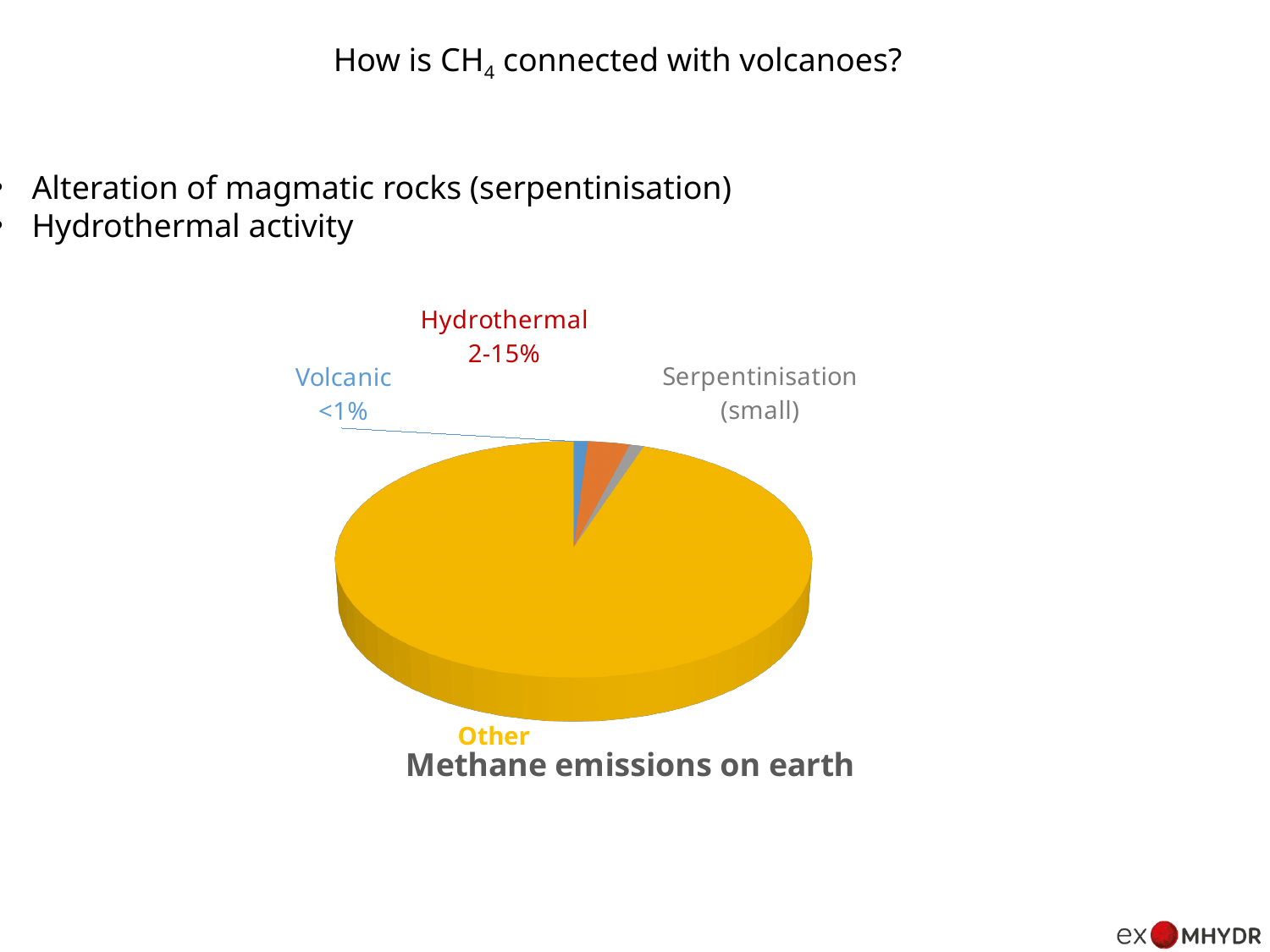
What value is labelled for the Volcanic slice of the pie chart? <1% What value is labelled for the Hydrothermal slice of the pie chart? 2-15% What is the title of the pie chart? Methane emissions on earth Which slice is larger in the pie chart, Hydrothermal or Volcanic? Hydrothermal What colour is the Other slice of the pie chart? yellow What kind of chart is shown on the slide? pie chart What is written in parentheses under the Serpentinisation label on the pie chart? small Which slice is larger in the pie chart, Other or Hydrothermal? Other How many slices does the pie chart have? 4 Which slice of the pie chart is the largest? Other